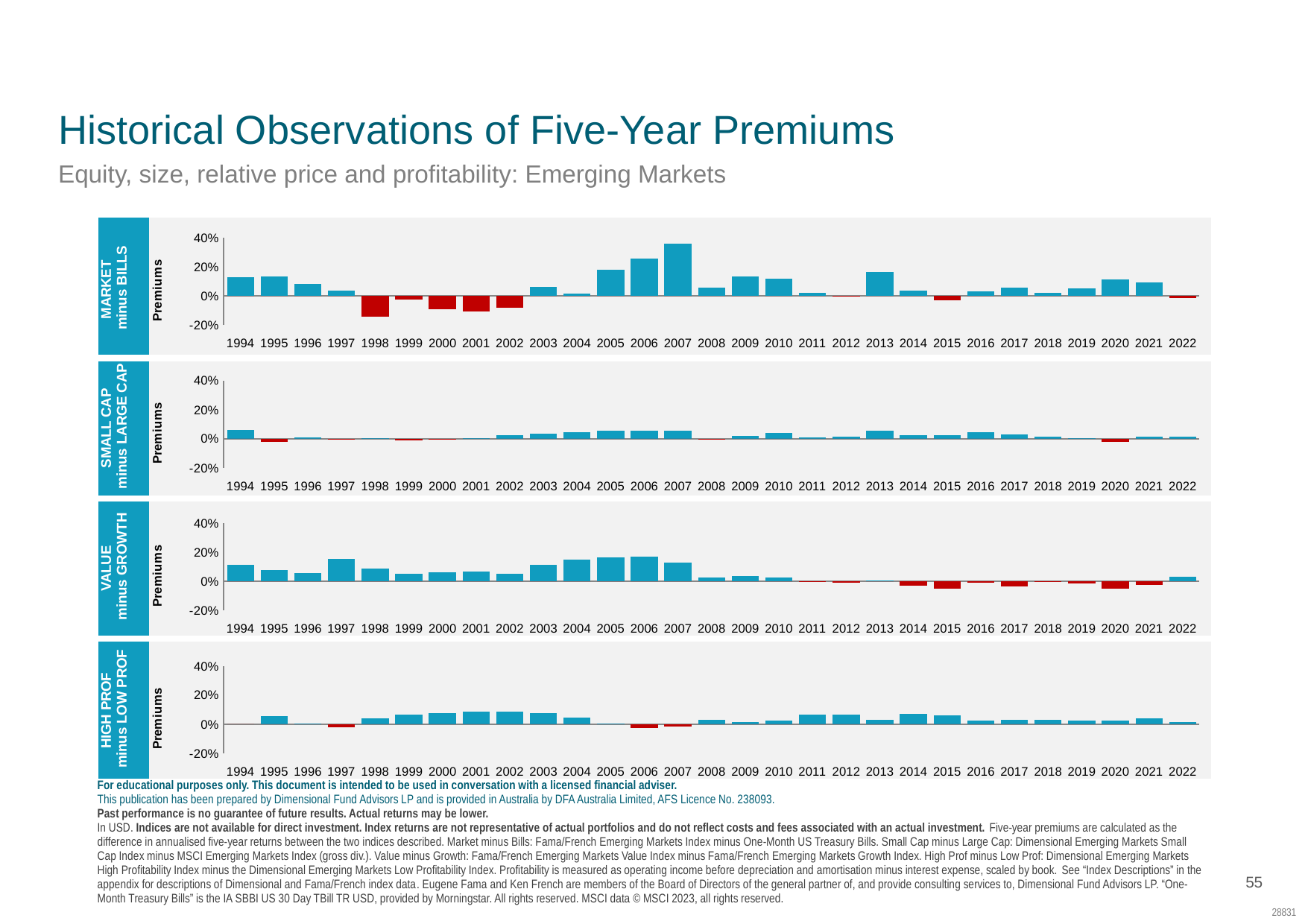
In the 'VALUE minus GROWTH' chart, which is larger, the value for 1997 or the value for 2008? 1997 How many charts are shown on the slide? 4 In the 'MARKET minus BILLS' chart, which year has the highest premium? 2007 In the 'MARKET minus BILLS' chart, how many years are plotted along the x axis? 29 What colour are the bars with negative values in the charts? red In the 'SMALL CAP minus LARGE CAP' chart, is the value for 1994 greater or less than 20%? less In the 'MARKET minus BILLS' chart, which is larger, the value for 2006 or the value for 2008? 2006 In the 'HIGH PROF minus LOW PROF' chart, which is larger, the value for 2001 or the value for 2008? 2001 In the 'MARKET minus BILLS' chart, which year has the lowest premium? 1998 What kind of chart is the 'MARKET minus BILLS' chart? bar chart In the 'MARKET minus BILLS' chart, is the value for 2013 greater or less than 20%? less In the 'MARKET minus BILLS' chart, is the value for 2007 greater or less than 20%? greater